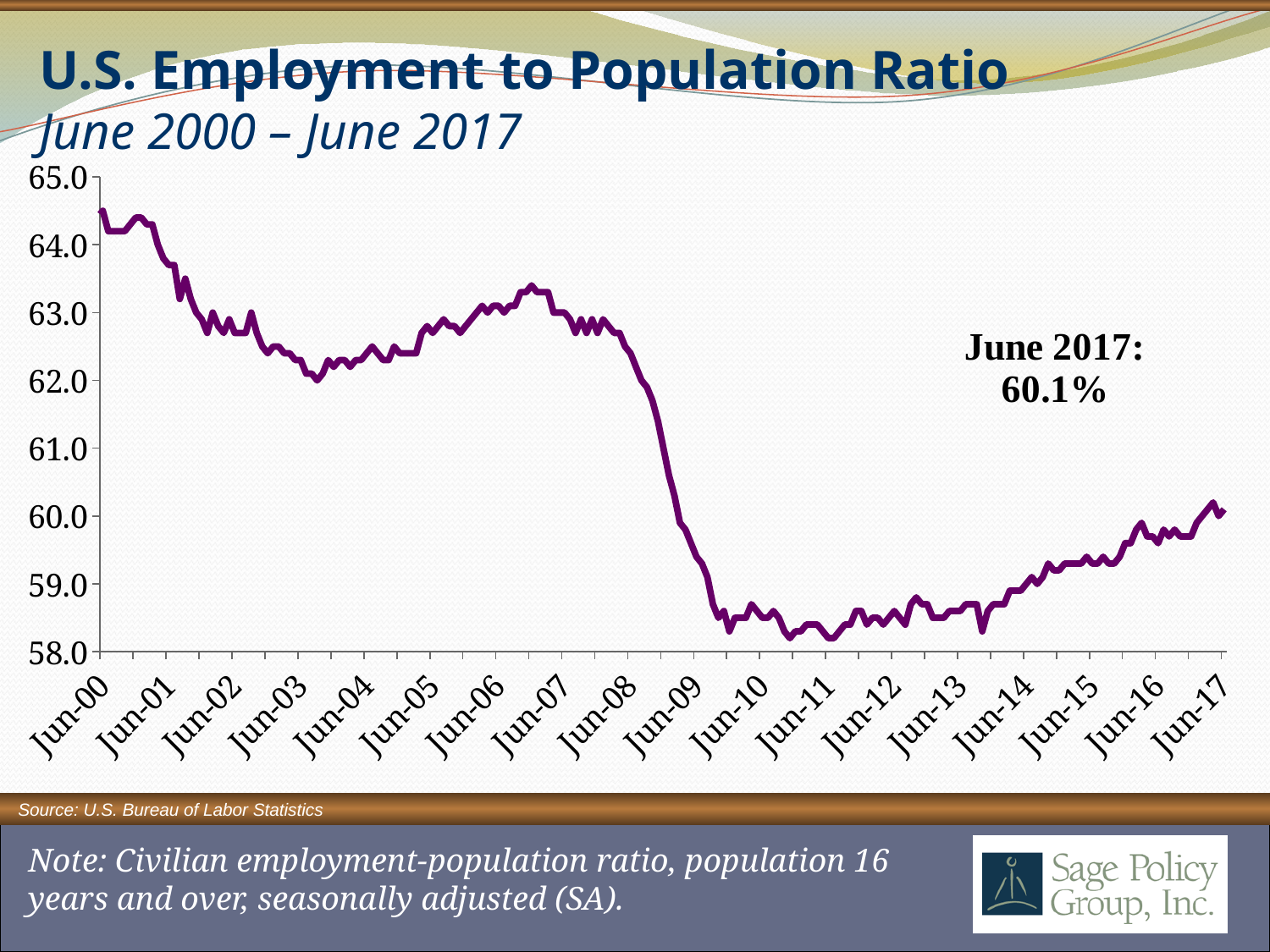
Is the value at Jun-05 greater or less than 62.0? greater Among the labeled x-axis dates, which has the highest value? Jun-00 Does the line rise or fall between Jun-11 and Jun-17? rise Which is larger, the value at Jun-08 or the value at Jun-11? Jun-08 Is the value at Jun-10 greater or less than 59.0? less Does the line rise or fall between Jun-08 and Jun-10? fall Is the value at Jun-09 greater or less than 60.0? less What is the employment to population ratio for June 2017? 60.1% What kind of chart is shown on the slide? line chart What is the title of the chart? U.S. Employment to Population Ratio Which is larger, the value at Jun-00 or the value at Jun-17? Jun-00